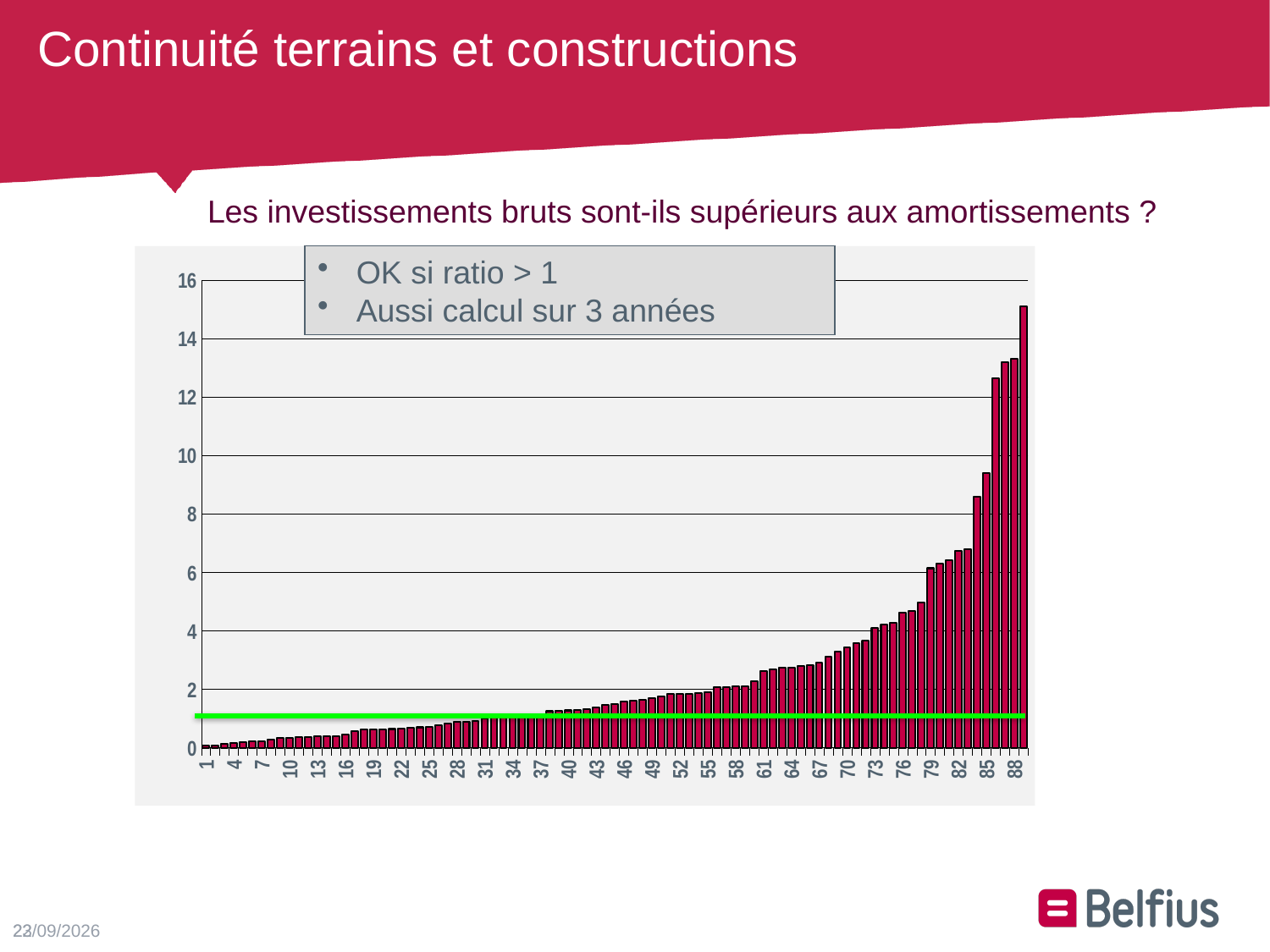
Is the value for category 70 greater or less than 2? greater At what value is the green horizontal line drawn across the chart? 1 Is the value for category 88 greater or less than 10? greater Do the bar values rise or fall from left to right along the x axis? rise Is the tallest bar greater or less than 14? greater What kind of chart is shown on the slide? bar chart What is the highest value shown on the y axis? 16 Which has the larger value, category 1 or category 88? 88